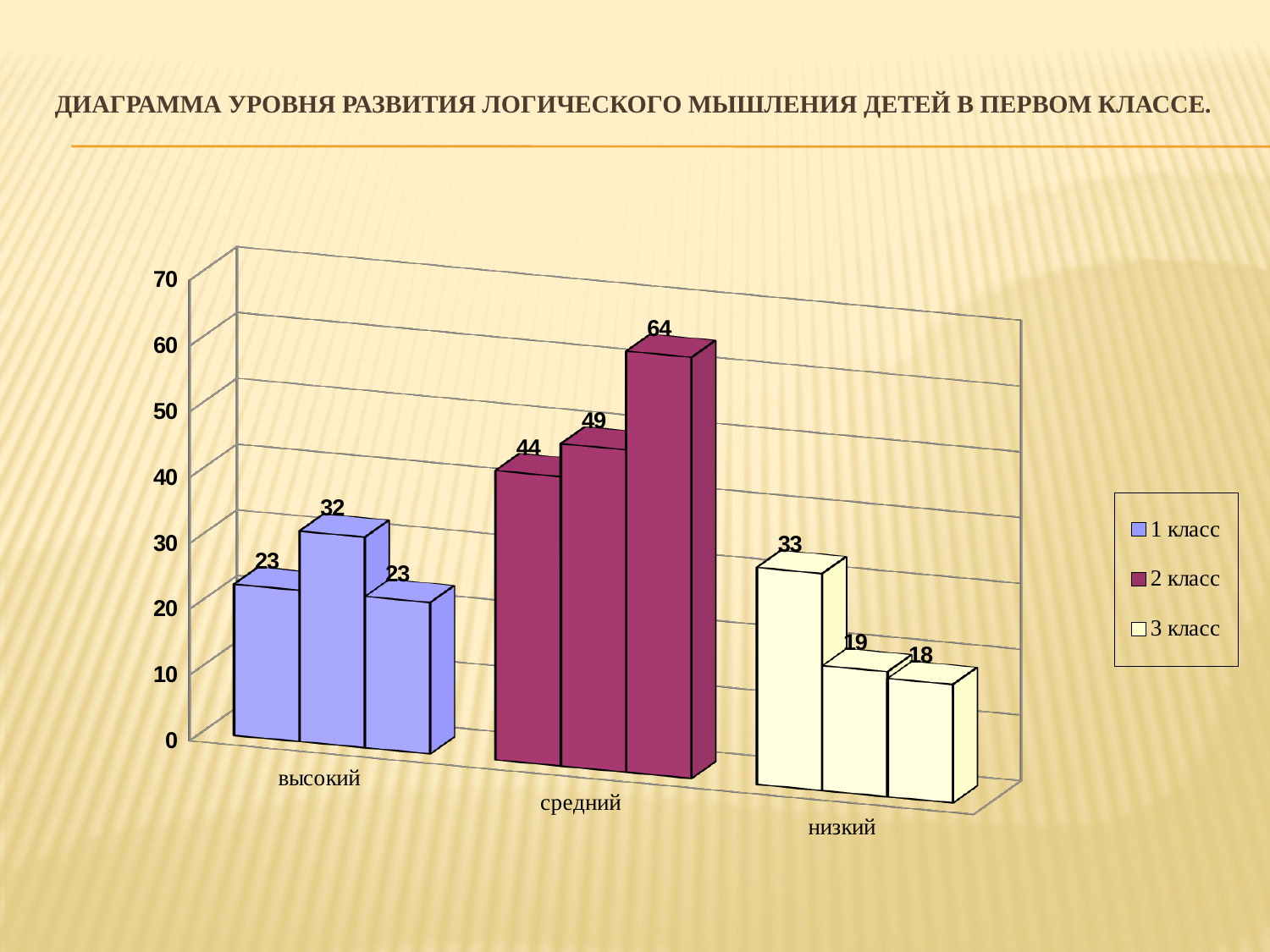
What is the difference between the highest and lowest bars in the 'средний' group (64 and 44)? 20 What are the three entries listed in the chart's legend? 1 класс, 2 класс, 3 класс How many categories are shown along the x axis of the chart? 3 What kind of chart is shown on the slide? Bar chart What is the value of the first (leftmost) bar in the 'низкий' group? 33 Which category group contains the highest bar on the chart? средний How many entries does the chart's legend list? 3 What is the value of the middle bar in the 'высокий' group? 32 Is the value of the tallest bar in the 'средний' group greater or less than 60? greater What is the difference between the first bar (33) and the last bar (18) in the 'низкий' group? 15 What is the lowest value labelled on the chart? 18 What is the value of the tallest bar in the 'средний' group? 64